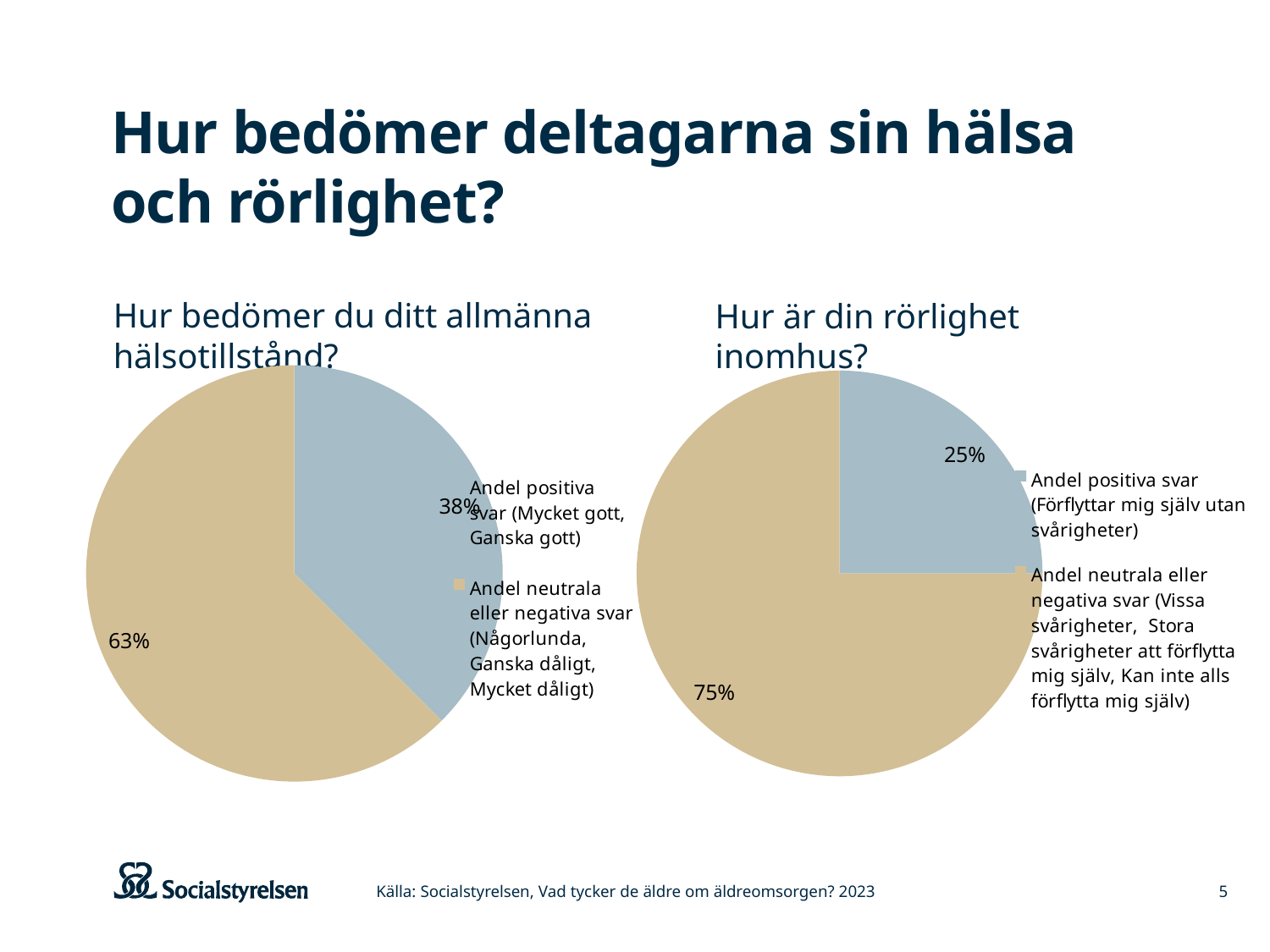
How many pie charts are shown on the slide? 2 In the chart 'Hur bedömer du ditt allmänna hälsotillstånd?', what share is 'Andel positiva svar'? 38% In the chart 'Hur är din rörlighet inomhus?', what is the difference between the neutral/negative share and the positive share? 50% In the chart 'Hur bedömer du ditt allmänna hälsotillstånd?', what is the difference between the neutral/negative share and the positive share? 25% In the chart 'Hur är din rörlighet inomhus?', which category has the smallest slice? Andel positiva svar In the chart 'Hur är din rörlighet inomhus?', what share is 'Andel neutrala eller negativa svar'? 75% In the chart 'Hur bedömer du ditt allmänna hälsotillstånd?', what share is 'Andel neutrala eller negativa svar'? 63% In the chart 'Hur bedömer du ditt allmänna hälsotillstånd?', which category has the largest slice? Andel neutrala eller negativa svar In the chart 'Hur är din rörlighet inomhus?', what share is 'Andel positiva svar'? 25% How many slices does the chart 'Hur bedömer du ditt allmänna hälsotillstånd?' have? 2 What type of chart is used for 'Hur är din rörlighet inomhus?'? Pie chart Which chart has the larger share of 'Andel positiva svar': 'Hur bedömer du ditt allmänna hälsotillstånd?' or 'Hur är din rörlighet inomhus?'? Hur bedömer du ditt allmänna hälsotillstånd?